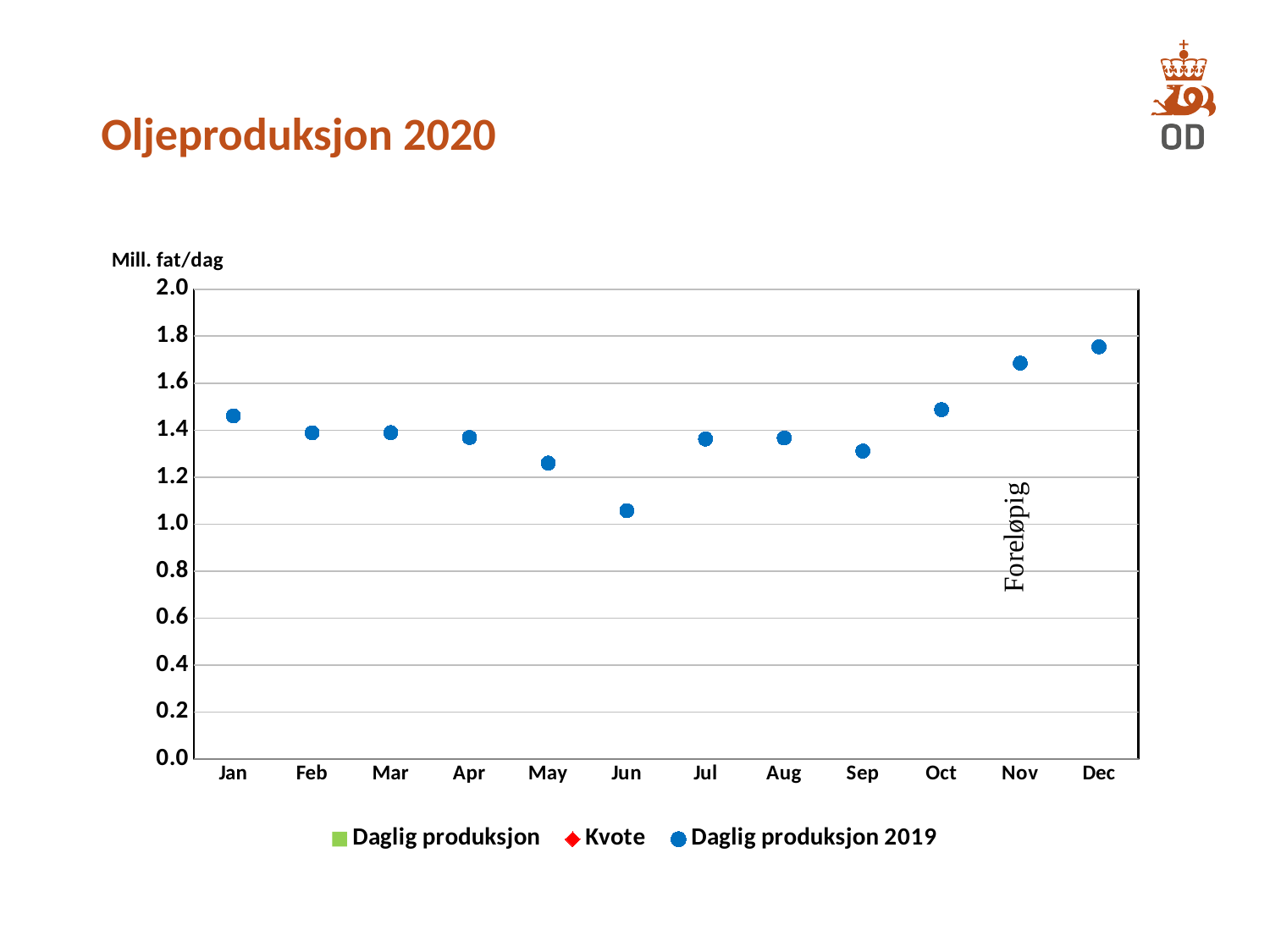
Is the Daglig produksjon 2019 value for Jan greater or less than 1.4? greater Is the Daglig produksjon 2019 value for Jun greater or less than 1.2? less What unit label is shown above the y axis? Mill. fat/dag Is the Daglig produksjon 2019 value for Nov greater or less than 1.6? greater In which month is the Daglig produksjon 2019 value lowest? Jun How many series does the legend list? 3 How many months are shown on the x axis? 12 What is the title of the chart on the slide? Oljeproduksjon 2020 In which month is the Daglig produksjon 2019 value highest? Dec Which series is plotted with blue circle markers? Daglig produksjon 2019 Which month has a higher Daglig produksjon 2019 value, Oct or Sep? Oct Do the Daglig produksjon 2019 values rise or fall from Sep to Dec? rise